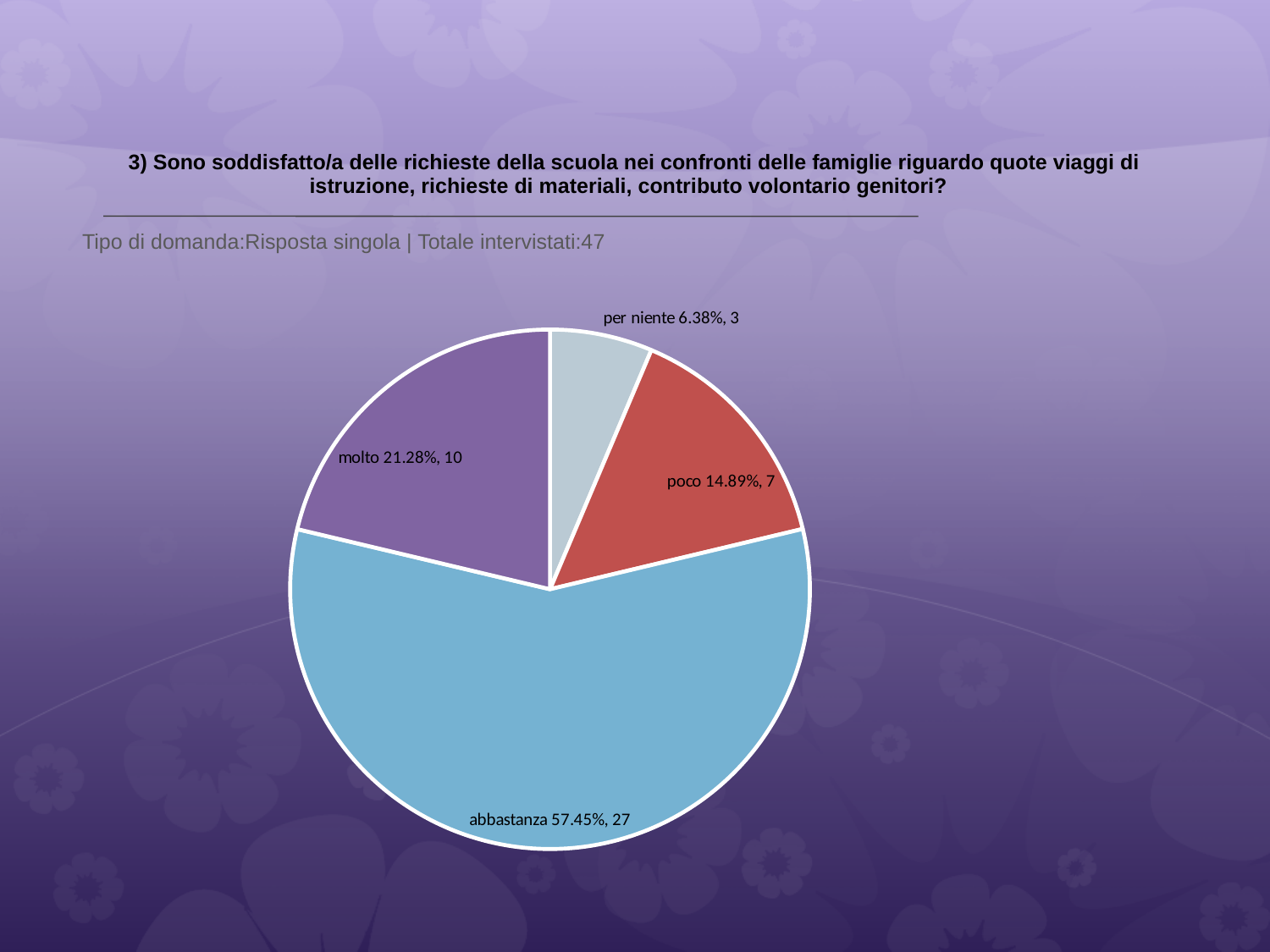
What percentage share does the 'abbastanza' slice have? 57.45% What is the total number of respondents shown in the pie chart? 47 What is the difference in number of respondents between 'abbastanza' and 'molto'? 17 What percentage share does the 'per niente' slice have? 6.38% Which has more respondents, 'poco' or 'molto'? molto Which response category has the largest slice? abbastanza Which response category has the smallest slice? per niente How many respondents answered 'molto'? 10 How many respondents answered 'poco'? 7 What colour is the 'abbastanza' slice? light blue What kind of chart is shown on the slide? pie chart How many slices does the pie chart have? 4